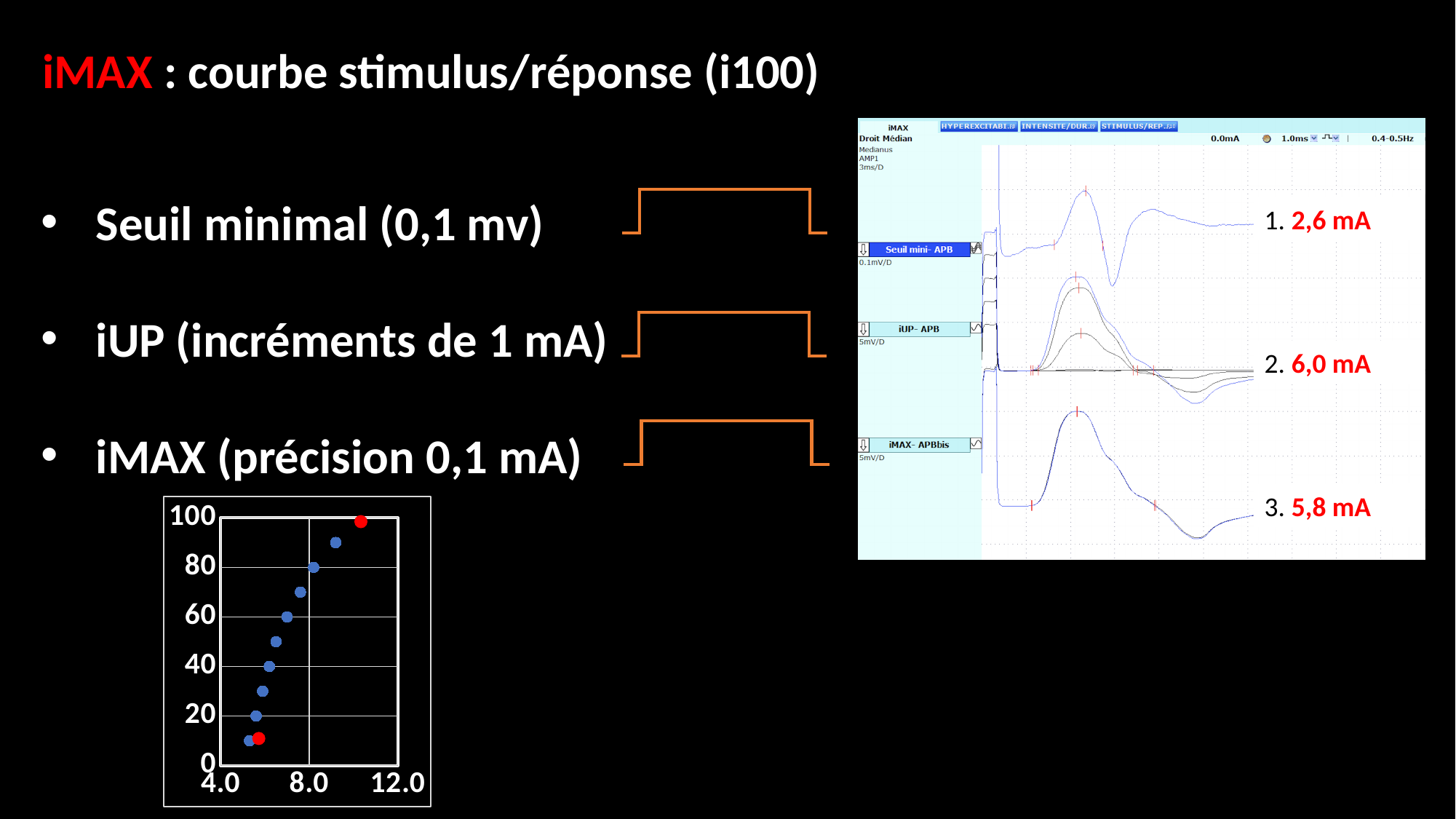
In the scatter chart at the bottom left, how many red points are plotted? 2 In the scatter chart at the bottom left, how many blue points are plotted? 9 In the scatter chart at the bottom left, is the y value of the lowest point greater or less than 20? less In the scatter chart at the bottom left, what is the highest value shown on the y axis? 100 In the scatter chart at the bottom left, is the x value of the highest point greater or less than 8.0? greater In the scatter chart at the bottom left, is the y value of the highest red point greater or less than 80? greater What kind of chart is shown at the bottom left of the slide? scatter chart In the scatter chart at the bottom left, what is the lowest value shown on the x axis? 4.0 In the scatter chart at the bottom left, do the values rise or fall as the x axis increases? rise